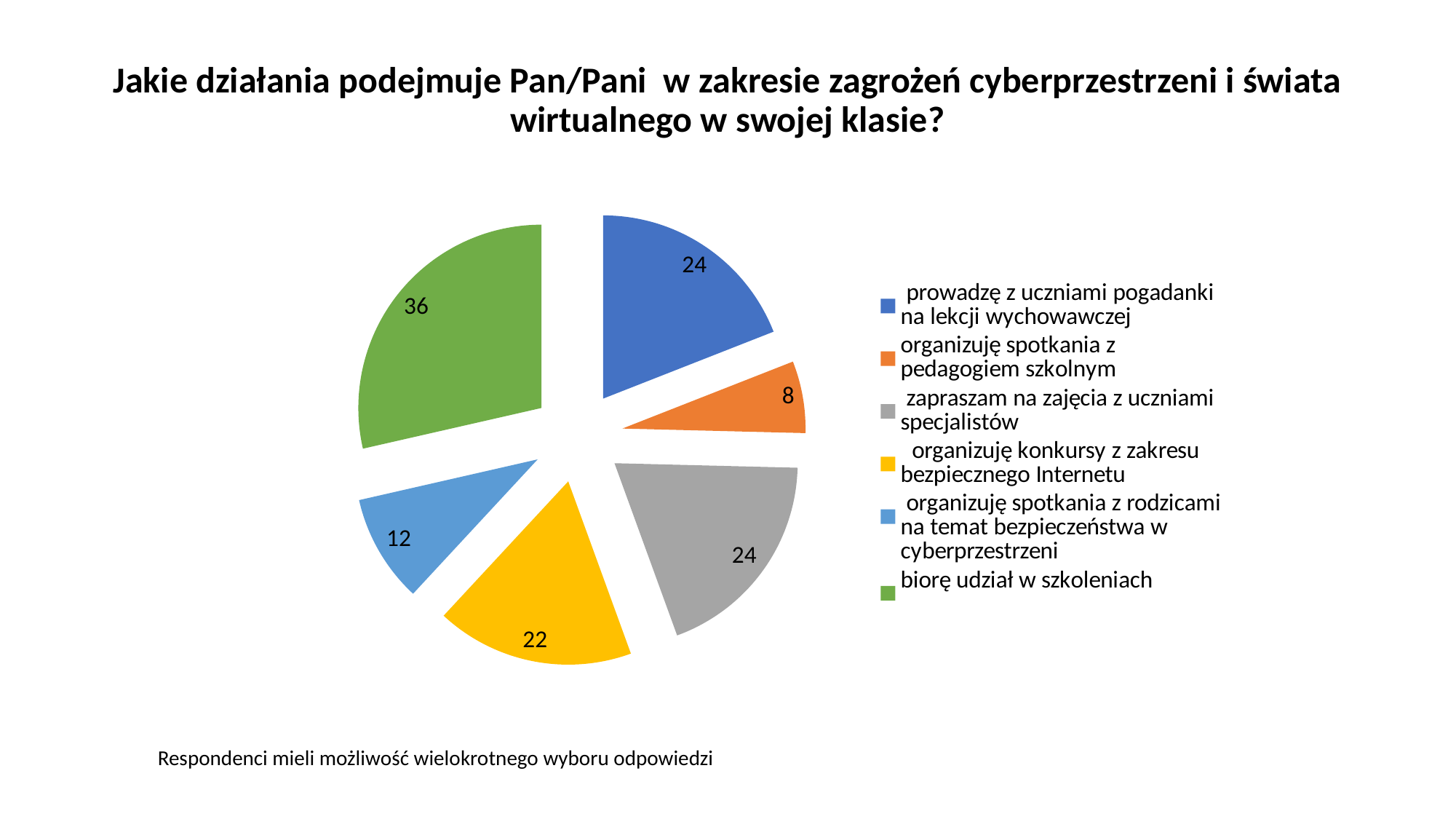
What is the value for "organizuję spotkania z rodzicami na temat bezpieczeństwa w cyberprzestrzeni"? 12 Which category has the smallest slice? organizuję spotkania z pedagogiem szkolnym How many slices does the pie chart have? 6 What is the value for "biorę udział w szkoleniach"? 36 What is the difference between the value for "biorę udział w szkoleniach" and the value for "organizuję spotkania z pedagogiem szkolnym"? 28 Which is larger: the value for "organizuję konkursy z zakresu bezpiecznego Internetu" or the value for "organizuję spotkania z rodzicami na temat bezpieczeństwa w cyberprzestrzeni"? organizuję konkursy z zakresu bezpiecznego Internetu How many entries does the legend list? 6 What is the value for "organizuję spotkania z pedagogiem szkolnym"? 8 What kind of chart is shown on the slide? pie chart What colour is the slice for "zapraszam na zajęcia z uczniami specjalistów"? grey Which category has the largest slice? biorę udział w szkoleniach What is the value for "organizuję konkursy z zakresu bezpiecznego Internetu"? 22